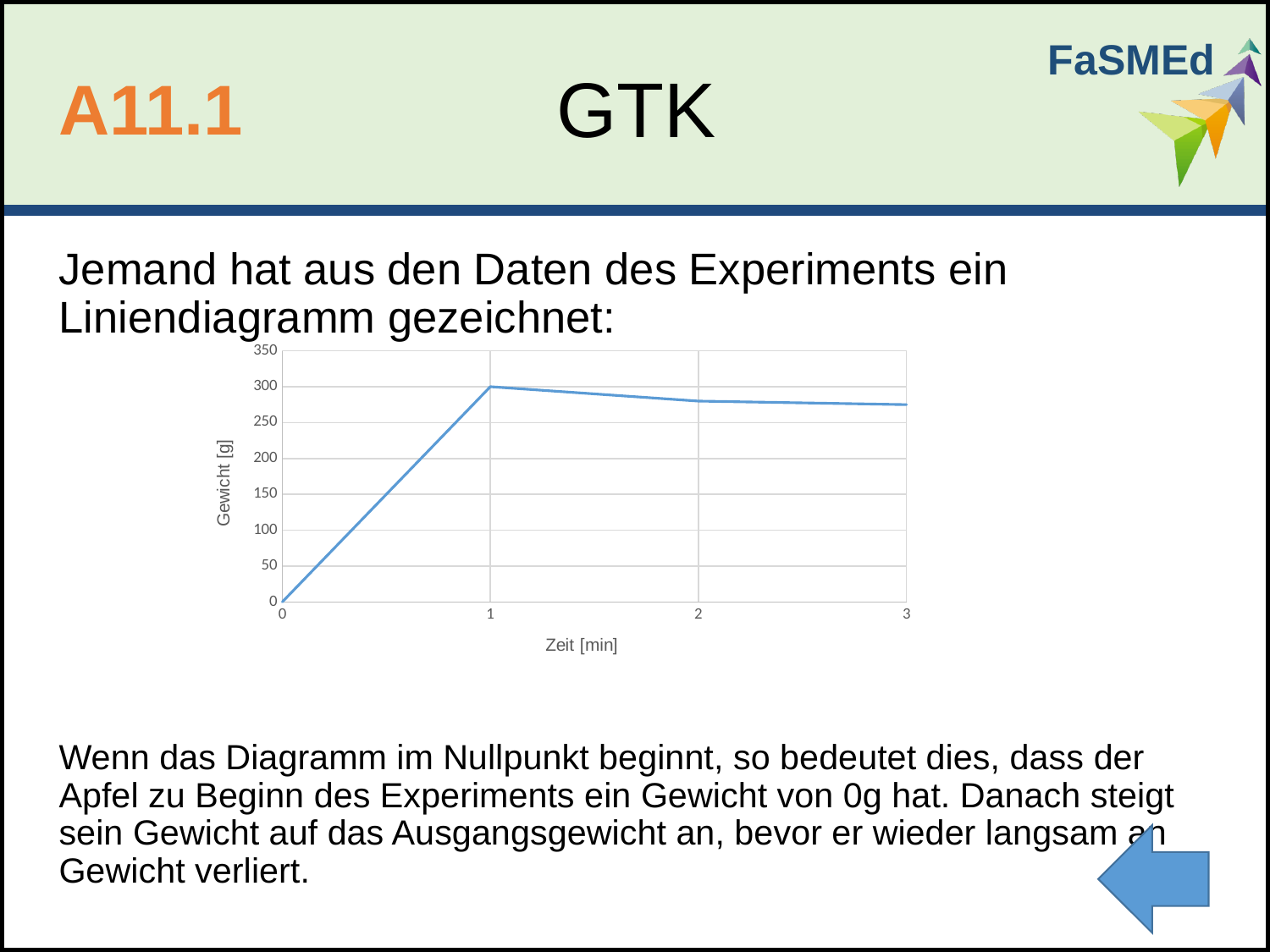
What is the label of the y axis? Gewicht [g] Do the values rise or fall between 1 min and 3 min? fall Is the value at 2 min greater or less than 250? greater What is the weight (Gewicht) at time 0 min? 0 What is the weight (Gewicht) at time 1 min? 300 Which is larger, the value at 1 min or the value at 2 min? 1 min What kind of chart is shown on the slide? line chart Is the value at 3 min greater or less than 300? less What is the label of the x axis? Zeit [min] At which time is the weight lowest? 0 min At which time is the weight highest? 1 min By how much does the weight increase from 0 min to 1 min? 300